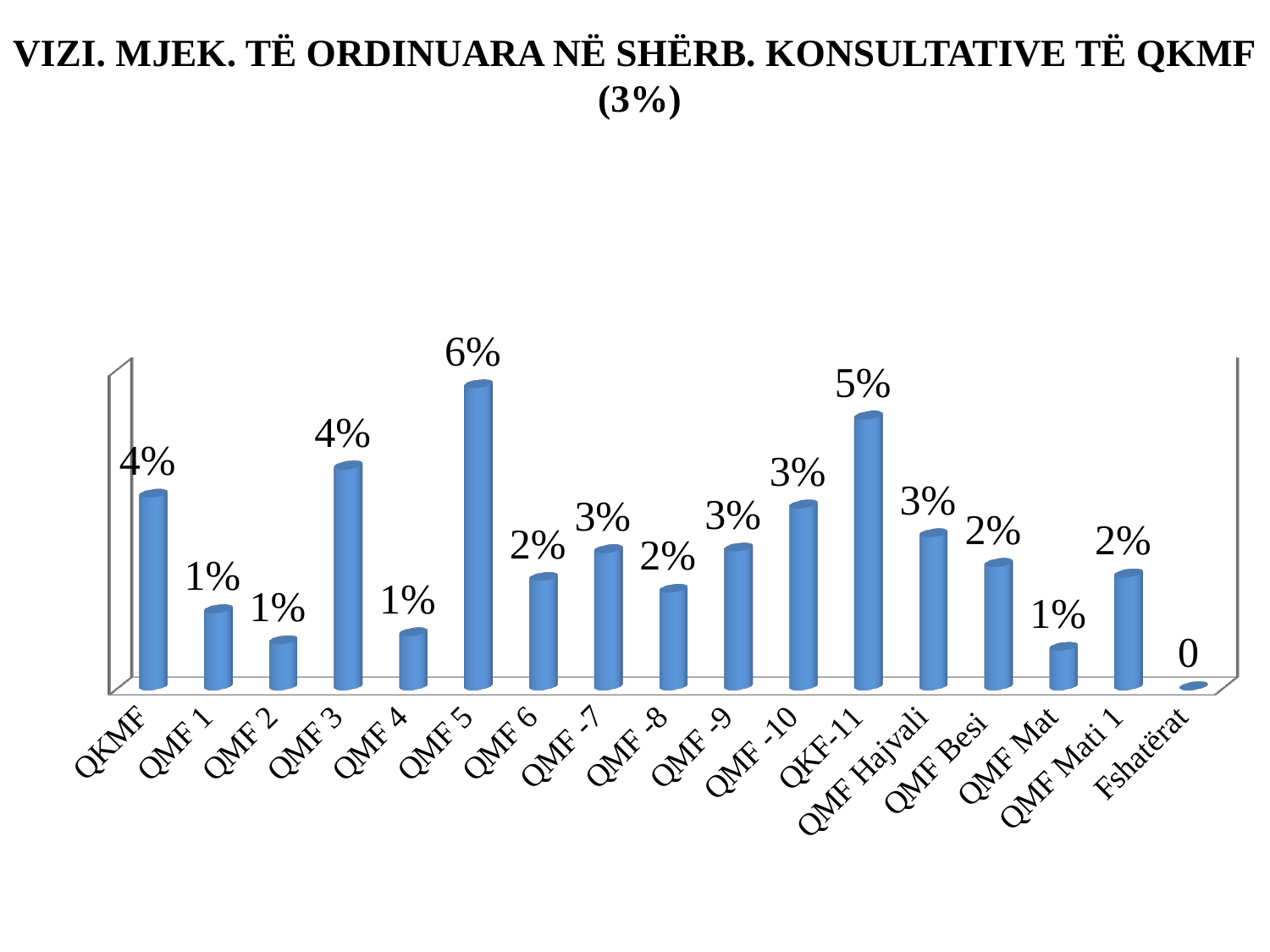
What is the value for QKF-11? 5% What is the difference between the values for QMF 5 and QKF-11? 1% What is the value for Fshatërat? 0 What is the value for QMF Mati 1? 2% Which is larger, the value for QMF 3 or the value for QMF 6? QMF 3 How many categories are shown on the x axis? 17 What is the value for QMF Hajvali? 3% What kind of chart is shown on the slide? Bar chart Which category has the highest value? QMF 5 Which category has the lowest value? Fshatërat What is the value for QMF 5? 6% What percentage is given in parentheses in the chart title? 3%